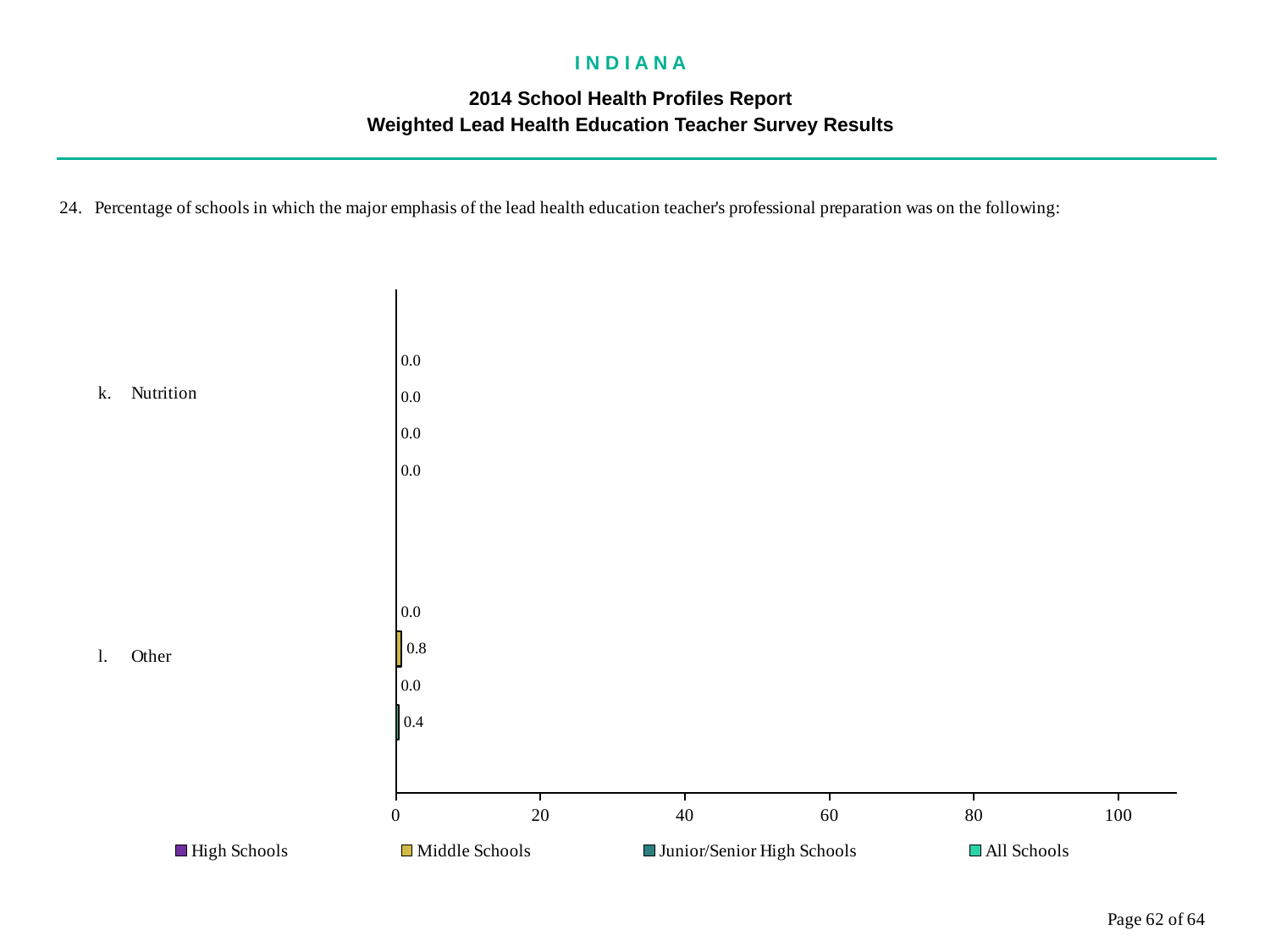
What is the value for High Schools in the 'Nutrition' category? 0.0 What type of chart is shown on the slide? bar chart How many series does the legend list? 4 Which series has the highest value in the 'Other' category? Middle Schools Which is larger in the 'Other' category: the Middle Schools value or the All Schools value? Middle Schools What is the value for All Schools in the 'Other' category? 0.4 Is the value for Middle Schools in the 'Other' category greater or less than 20? less How many categories are plotted on the chart? 2 What is the value for Junior/Senior High Schools in the 'Other' category? 0.0 What is the last series listed in the legend? All Schools What is the difference between the Middle Schools and All Schools values in the 'Other' category? 0.4 What is the value for Middle Schools in the 'Other' category? 0.8